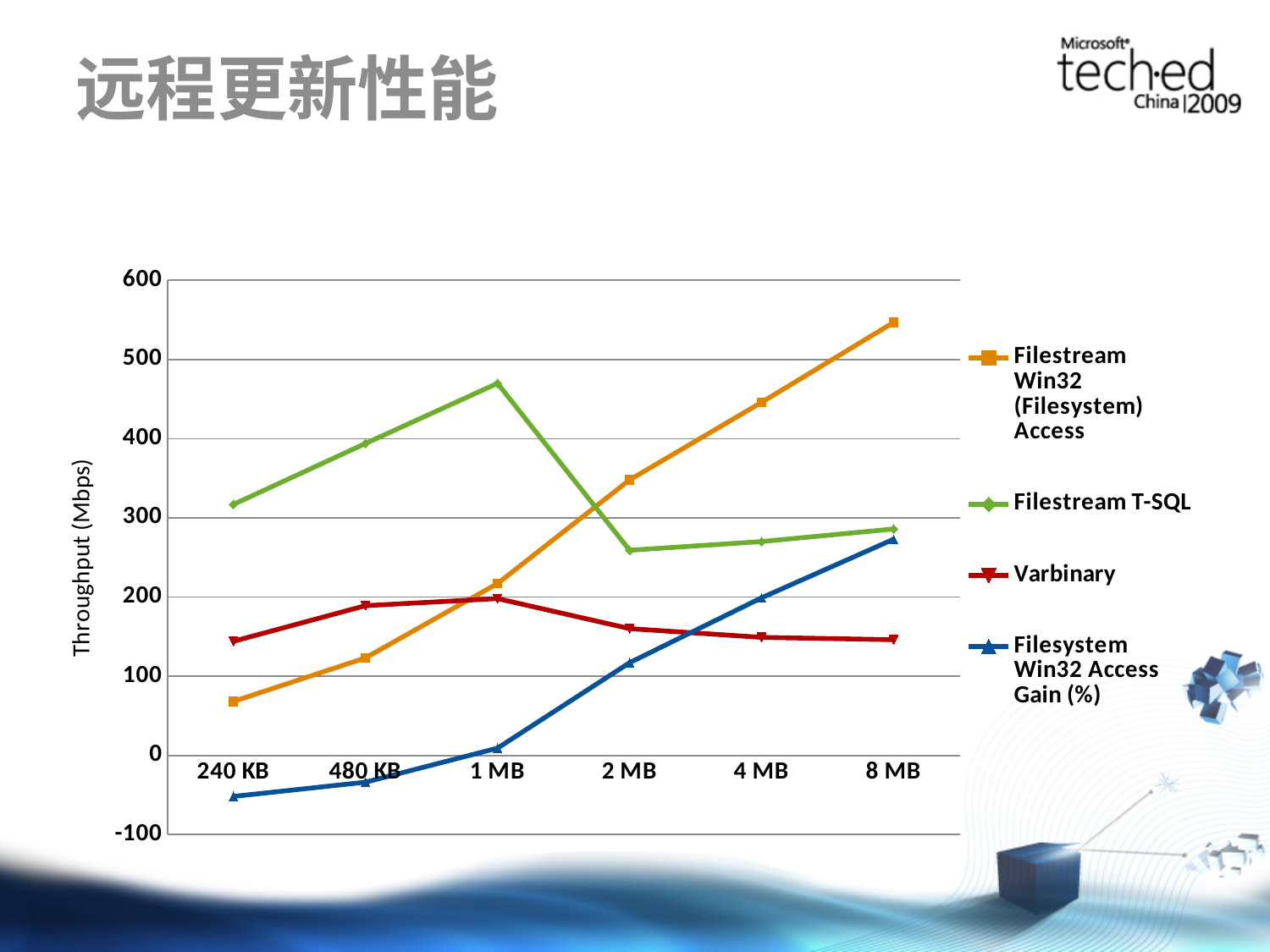
At 2 MB, which is larger: Filestream Win32 (Filesystem) Access or Varbinary? Filestream Win32 (Filesystem) Access What kind of chart is shown on the slide? Line chart How many series does the legend list? 4 At 240 KB, which is larger: Filestream T-SQL or Filestream Win32 (Filesystem) Access? Filestream T-SQL What is the title of the vertical axis? Throughput (Mbps) Is the value for Filesystem Win32 Access Gain (%) at 240 KB greater or less than 0? less Does the Filestream Win32 (Filesystem) Access series rise or fall as file size increases from 240 KB to 8 MB? Rises At which file size is the Filestream Win32 (Filesystem) Access series lowest? 240 KB Which series has the highest value at 8 MB? Filestream Win32 (Filesystem) Access Is the value for Filestream Win32 (Filesystem) Access at 8 MB greater or less than 500? greater At which file size does the Filestream T-SQL series reach its highest value? 1 MB How many file-size categories are shown on the x axis? 6